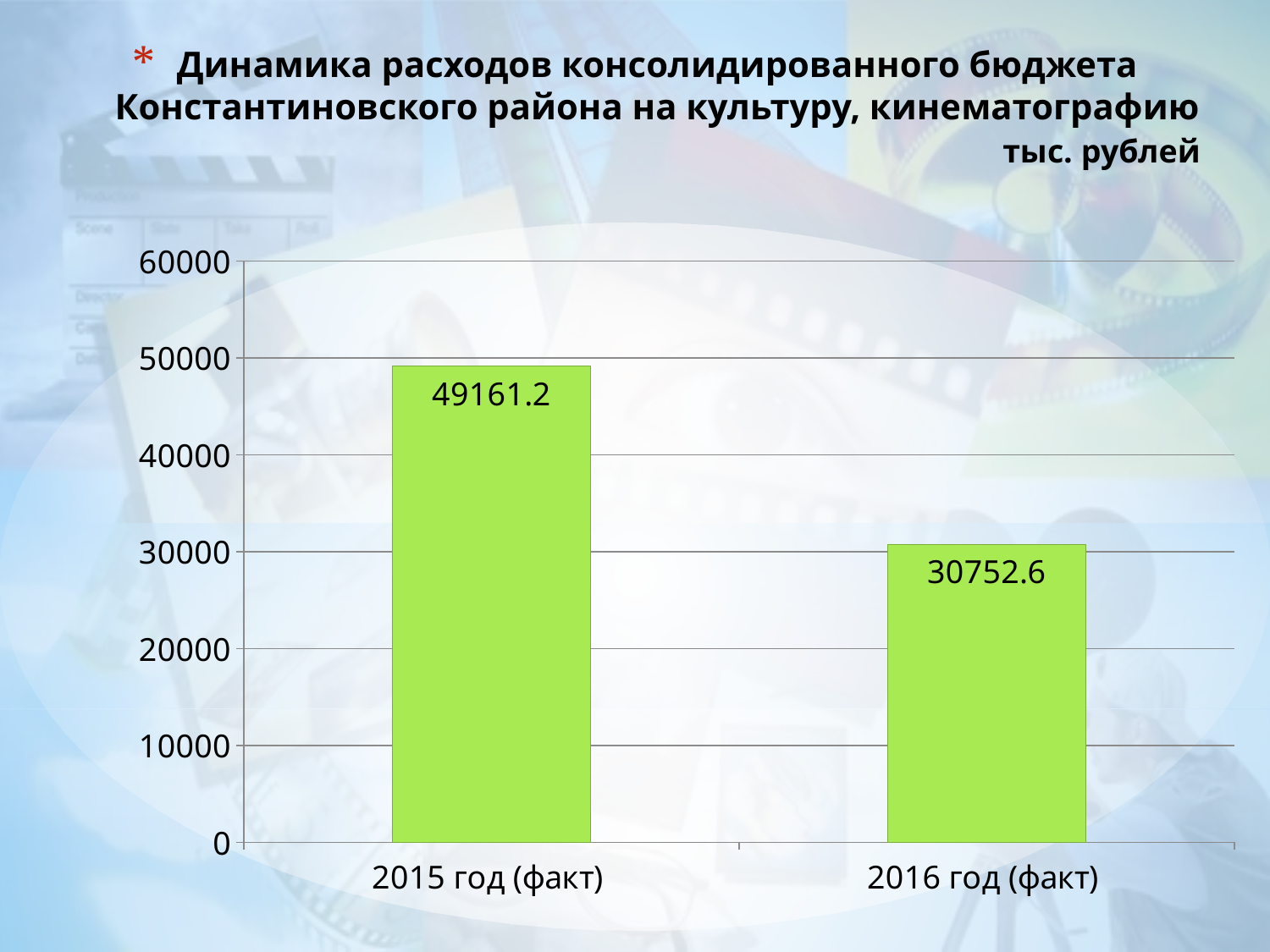
In what units are the values on the chart expressed, according to the slide? тыс. рублей What is the difference between the values for 2015 год (факт) and 2016 год (факт)? 18408.6 What is the value for 2015 год (факт)? 49161.2 What is the value for 2016 год (факт)? 30752.6 Do the values rise or fall from 2015 год (факт) to 2016 год (факт)? fall Which category has the lowest value? 2016 год (факт) How many categories are shown on the x axis? 2 Which is larger, the value for 2015 год (факт) or the value for 2016 год (факт)? 2015 год (факт) Is the value for 2015 год (факт) greater or less than 40000? greater What kind of chart is shown on the slide? bar chart Is the value for 2016 год (факт) greater or less than 40000? less Which category has the highest value? 2015 год (факт)